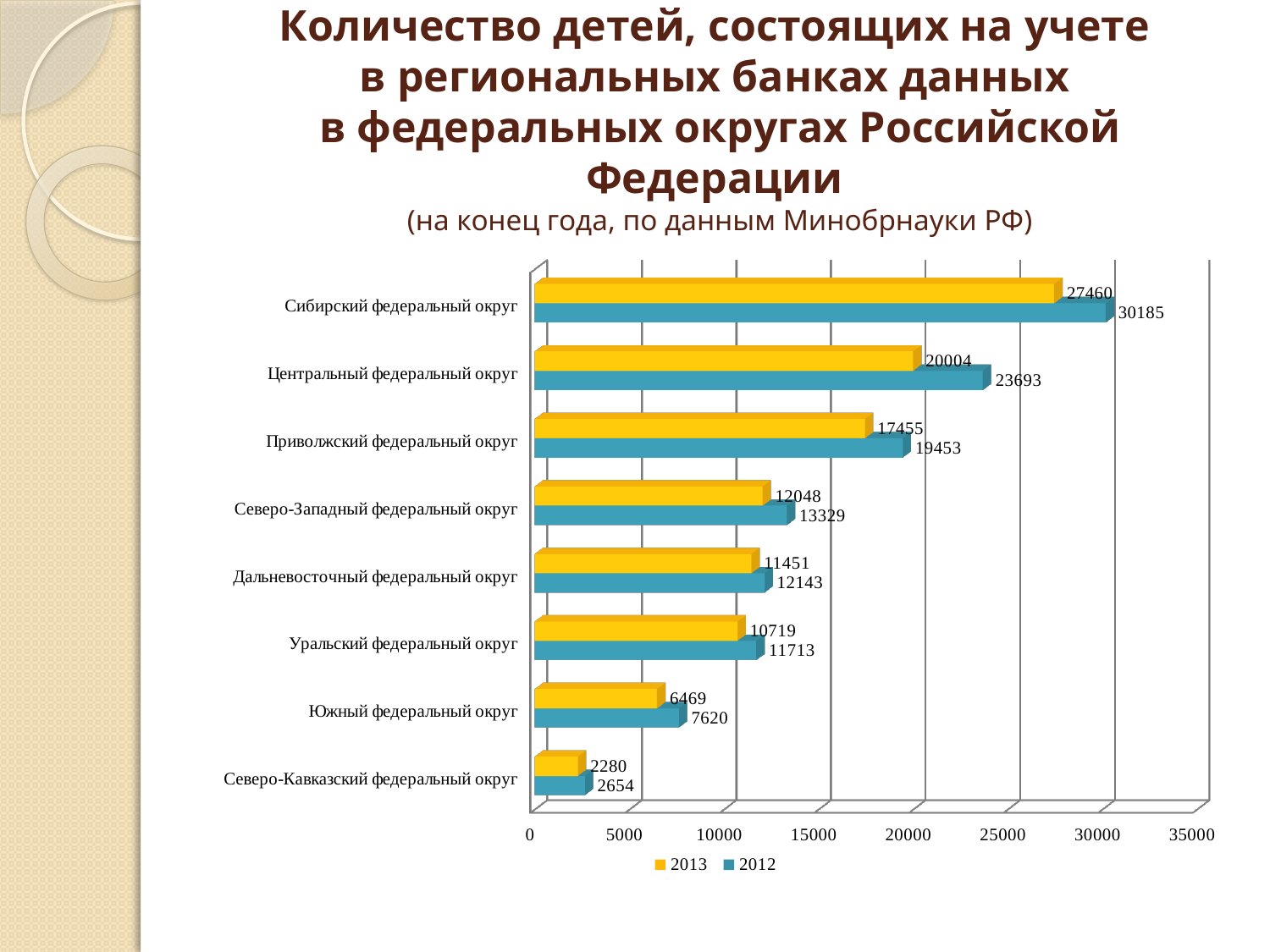
Which colour represents the 2013 series in the legend? yellow What is the 2013 value for Южный федеральный округ? 6469 Is the 2012 value for Северо-Западный федеральный округ greater or less than 15000? less Which federal district has the lowest 2013 value? Северо-Кавказский федеральный округ How many series does the legend list? 2 What is the 2013 value for Сибирский федеральный округ? 27460 For Уральский федеральный округ, which year has the larger value, 2012 or 2013? 2012 What kind of chart is shown on the slide? bar chart How many federal districts are shown on the chart? 8 What is the difference between the 2012 and 2013 values for Приволжский федеральный округ? 1998 Which federal district has the highest 2012 value? Сибирский федеральный округ What is the 2012 value for Центральный федеральный округ? 23693